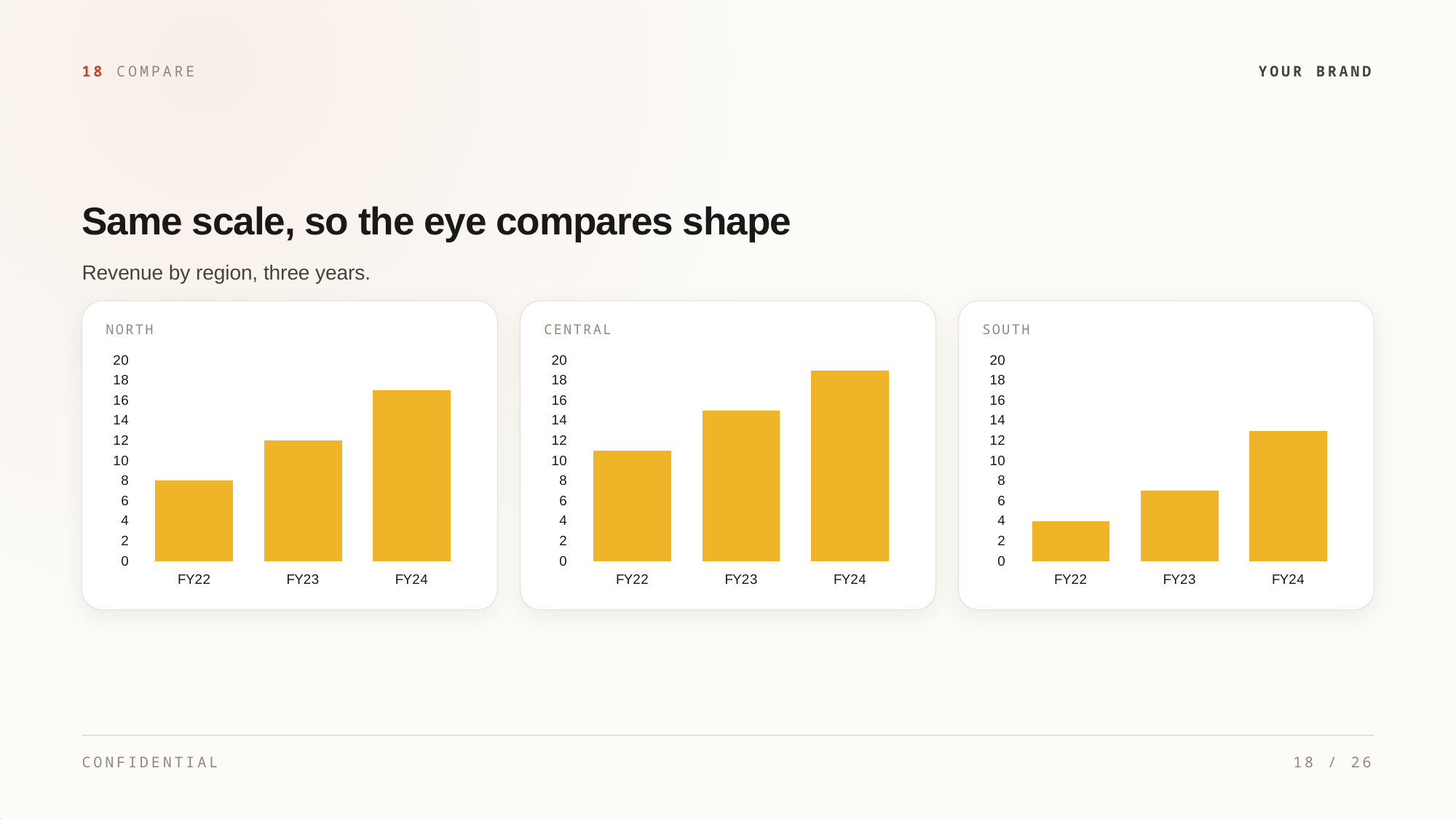
In the SOUTH chart, what is the value for FY22? 4 Which is larger: the FY24 value in the CENTRAL chart or the FY24 value in the NORTH chart? CENTRAL In the NORTH chart, what is the value for FY22? 8 In the SOUTH chart, which year has the lowest value? FY22 In the CENTRAL chart, which year has the highest value? FY24 In the CENTRAL chart, is the value for FY24 greater or less than 18? greater In the NORTH chart, how many bars are plotted? 3 What is the title of the chart on the right of the slide? SOUTH Do the values in the CENTRAL chart rise or fall from FY22 to FY24? rise What kind of chart is used in the NORTH panel? bar chart In the SOUTH chart, is the value for FY23 greater or less than 8? less In the NORTH chart, is the value for FY24 greater or less than 16? greater